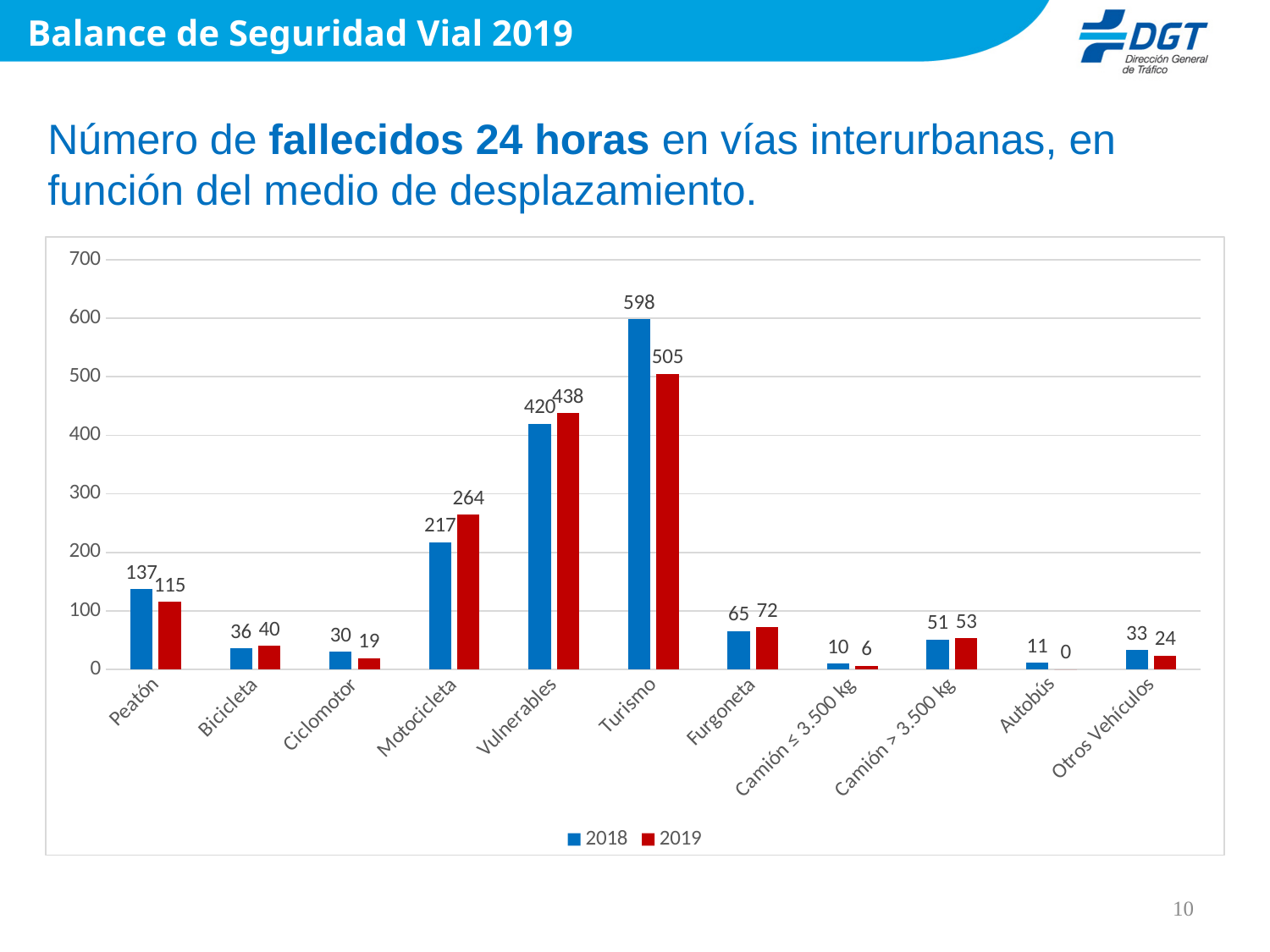
Which colour represents the 2019 series? red What kind of chart is shown? bar chart What is the 2019 value for Autobús? 0 Is the 2019 value for Vulnerables greater or less than 400? greater How many series does the legend list? 2 How many categories are shown on the x axis? 11 Which is larger for Peatón, the 2018 value or the 2019 value? 2018 What is the 2019 value for Turismo? 505 What is the difference between the 2018 and 2019 values for Turismo? 93 What is the 2018 value for Motocicleta? 217 Which category has the lowest 2019 value? Autobús Which category has the highest 2018 value? Turismo